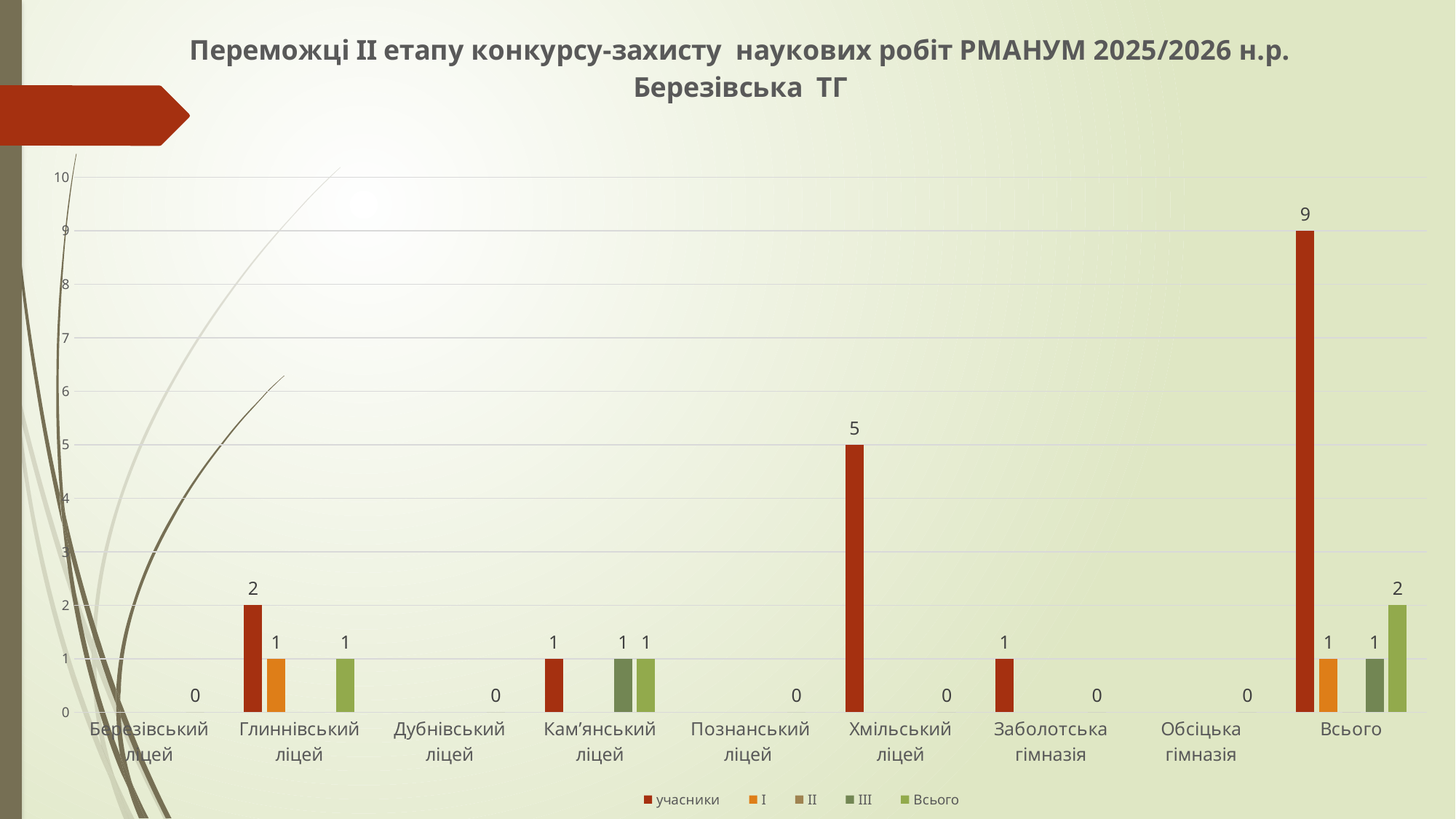
How many series does the legend list? 5 Is the учасники value for Всього greater or less than 8? greater What kind of chart is shown on the slide? bar chart What is the value of the учасники series for Хмільський ліцей? 5 What is the value of the Всього series for the Всього category? 2 Which category has the highest value in the учасники series? Всього How many categories are shown on the x axis? 9 What is the difference between the учасники value for Всього and the учасники value for Хмільський ліцей? 4 Which has the larger учасники value, Глиннівський ліцей or Кам’янський ліцей? Глиннівський ліцей What is the value of series I for Глиннівський ліцей? 1 What is the value of the учасники series for the Всього category? 9 What is the value of series III for Кам’янський ліцей? 1